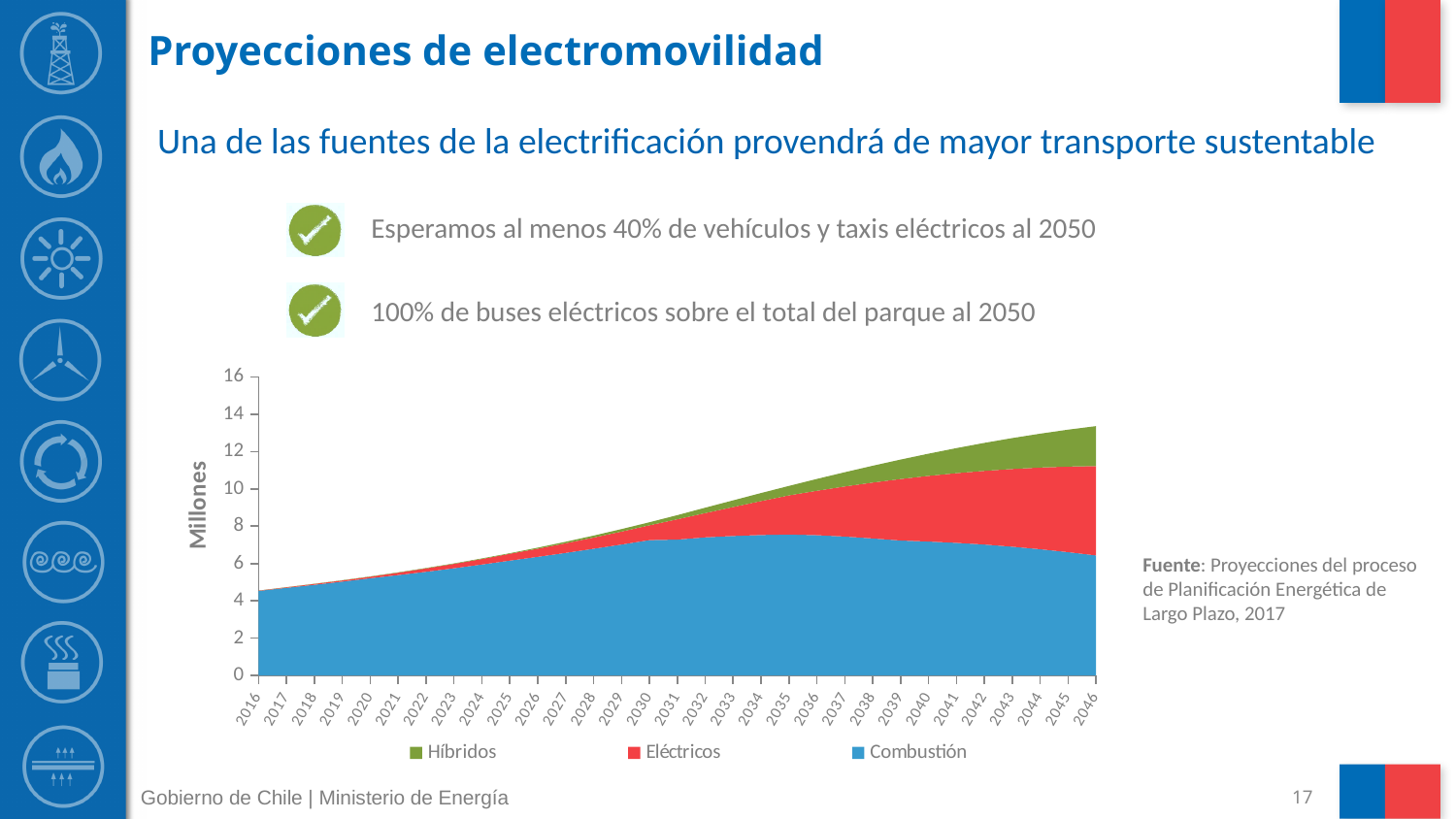
What kind of chart is shown on the slide? Stacked area chart Does the Combustión series rise or fall between 2036 and 2046? Fall Is the total stacked value in 2046 greater or less than 12? greater How many years are shown along the x axis of the chart? 31 How many series does the chart legend list? 3 In 2046, which series has the larger value: Eléctricos or Híbridos? Eléctricos Is the total stacked value in 2016 greater or less than 6? less Is the value for Combustión in 2046 greater or less than 8? less What is the first year and the last year shown on the x axis? 2016 and 2046 Does the total of all three series rise or fall from 2016 to 2046? Rise What is the label on the vertical axis of the chart? Millones Which series are listed in the chart legend? Híbridos, Eléctricos, Combustión